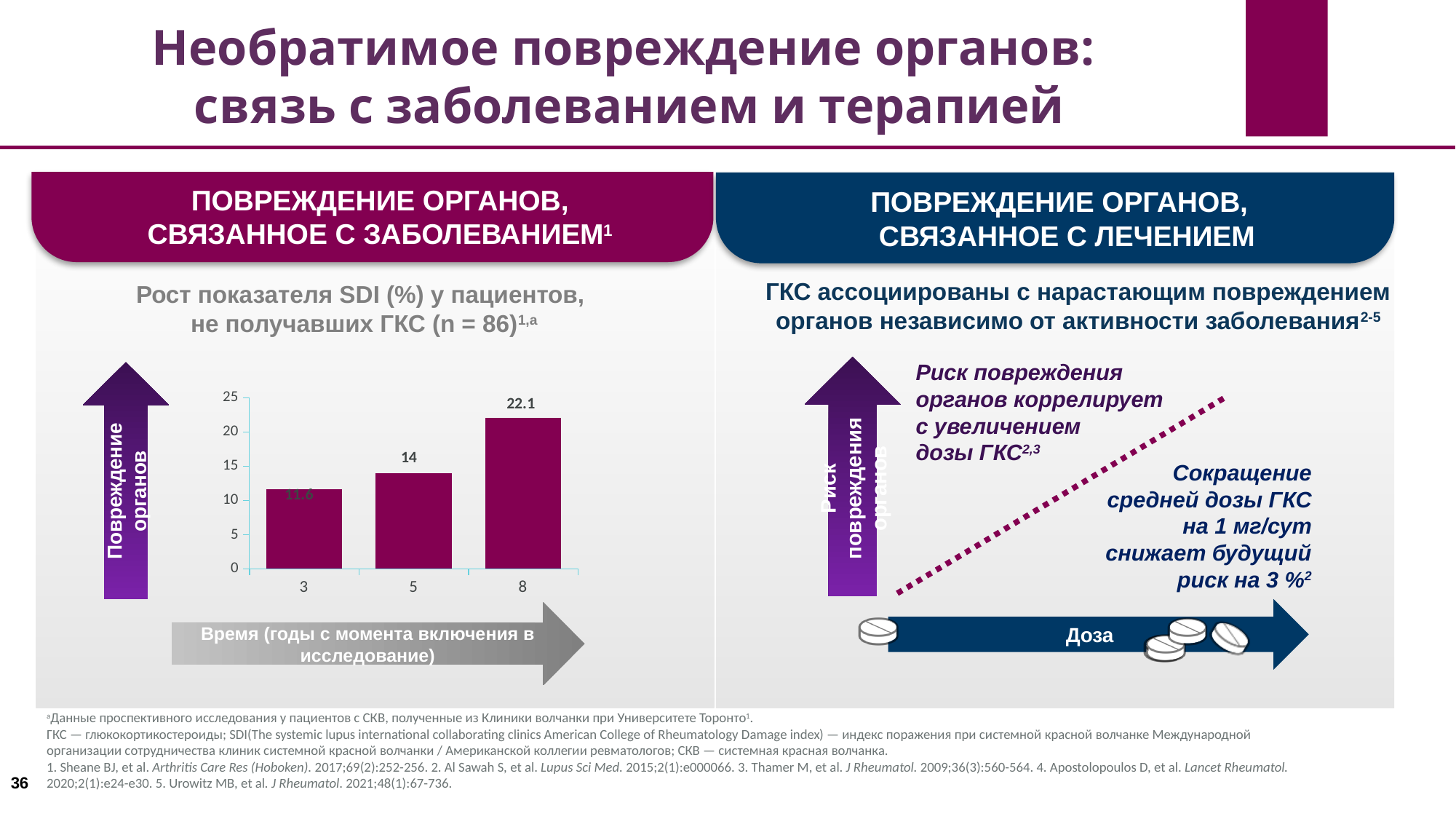
What is the SDI value for year 8? 22.1 What is the difference between the SDI values for year 5 and year 3? 2.4 Which is larger, the SDI value for year 5 or for year 3? Year 5 What is the SDI value for year 3? 11.6 What is the SDI value for year 5? 14 Which year has the lowest SDI value? 3 Which year has the highest SDI value? 8 What type of chart is shown on the slide? Bar chart What is the difference between the SDI values for year 8 and year 5? 8.1 How many bars are shown in the chart? 3 Do the SDI values rise or fall as the years increase along the x axis? Rise Is the value for year 8 greater or less than 20? greater